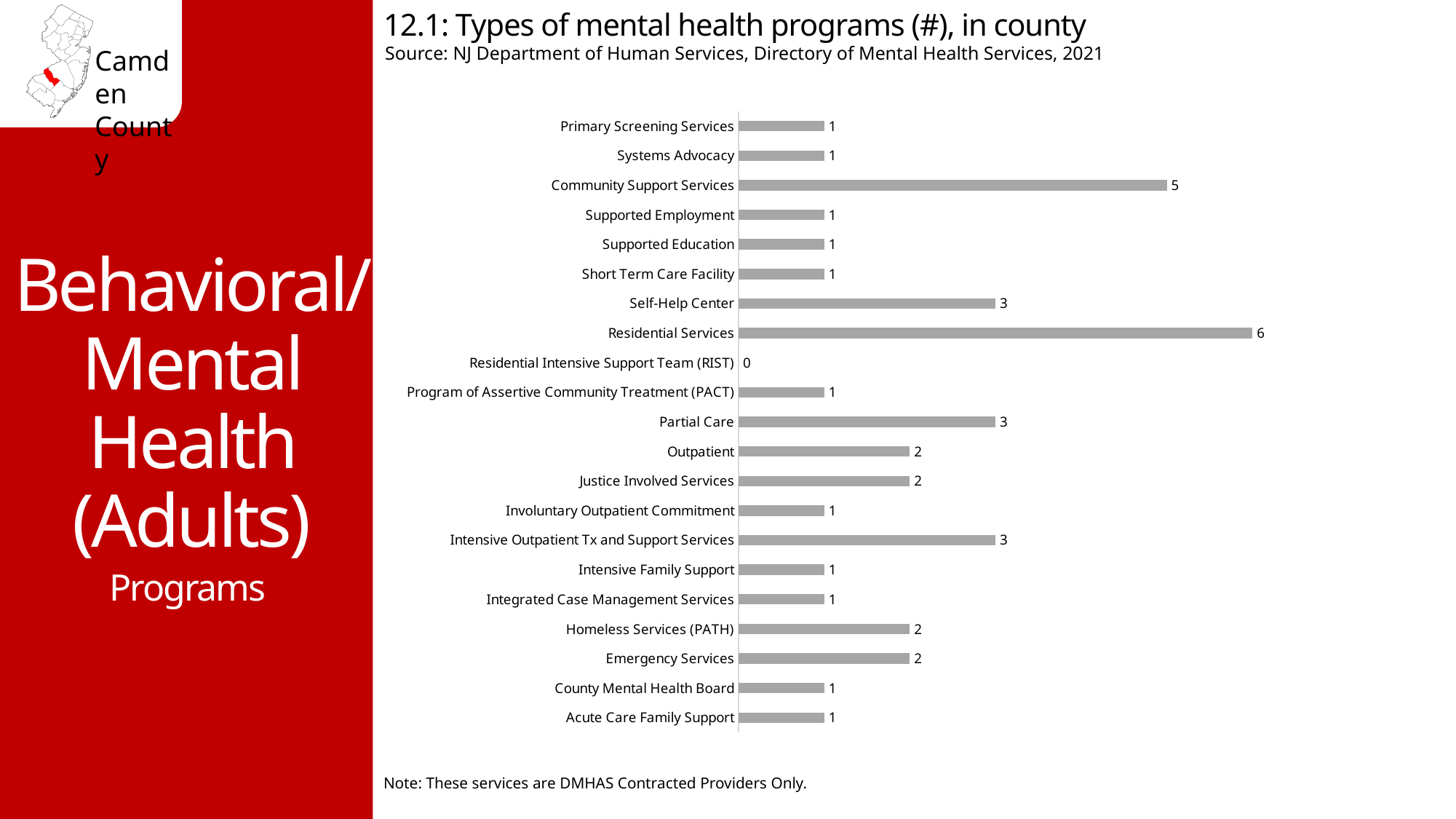
How many Residential Services programs are shown in the chart? 6 How many Outpatient programs are shown? 2 Which type of mental health program has the highest count? Residential Services What is the difference between the number of Residential Services programs and Community Support Services programs? 1 What is the value for Community Support Services? 5 What is the difference between the number of Self-Help Center programs and Emergency Services programs? 1 What is the value for Residential Intensive Support Team (RIST)? 0 How many program types are listed in the chart? 21 What kind of chart is shown on the slide? Bar chart Which type of mental health program has the lowest count? Residential Intensive Support Team (RIST) What is the title of the chart? 12.1: Types of mental health programs (#), in county Which has more programs, Partial Care or Homeless Services (PATH)? Partial Care